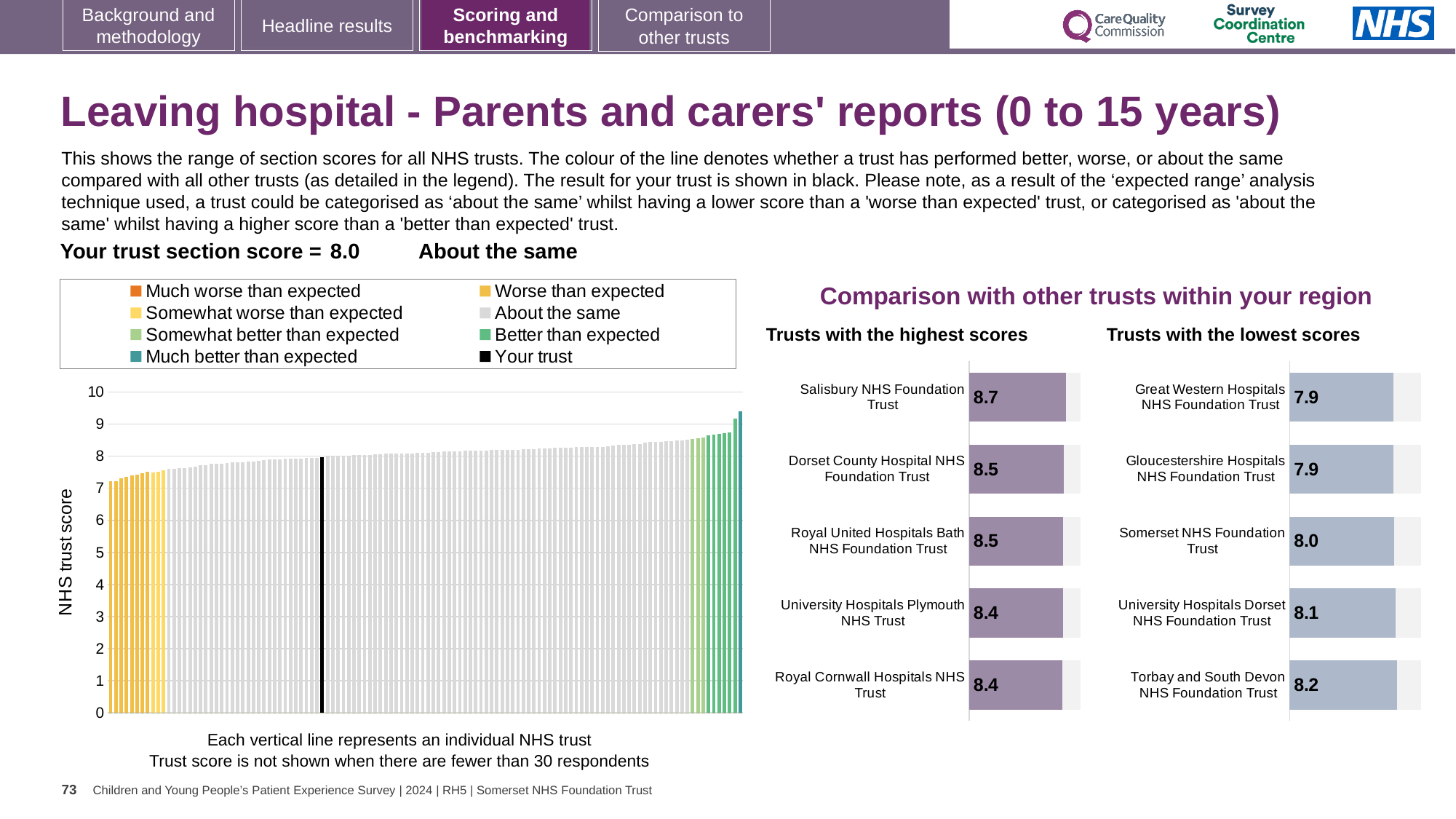
How many trusts are listed in the 'Trusts with the highest scores' chart? 5 In the 'Trusts with the lowest scores' chart, what is the score for Torbay and South Devon NHS Foundation Trust? 8.2 How many entries does the legend of the 'NHS trust score' chart on the left list? 8 In the 'Trusts with the highest scores' chart, what is the difference between the scores of Salisbury NHS Foundation Trust and Royal Cornwall Hospitals NHS Trust? 0.3 What kind of chart is the 'NHS trust score' chart on the left of the slide? Bar chart In the 'Trusts with the lowest scores' chart, which trust has the highest score shown? Torbay and South Devon NHS Foundation Trust In the 'Trusts with the highest scores' chart, what is the score for Salisbury NHS Foundation Trust? 8.7 In the 'Trusts with the highest scores' chart, which trust has the highest score? Salisbury NHS Foundation Trust In the 'Trusts with the highest scores' chart, what is the score for University Hospitals Plymouth NHS Trust? 8.4 In the 'Trusts with the lowest scores' chart, what is the score for Somerset NHS Foundation Trust? 8.0 In the 'Trusts with the lowest scores' chart, which has the larger score: Somerset NHS Foundation Trust or University Hospitals Dorset NHS Foundation Trust? University Hospitals Dorset NHS Foundation Trust In the 'Trusts with the lowest scores' chart, what is the difference between the scores of Torbay and South Devon NHS Foundation Trust and Great Western Hospitals NHS Foundation Trust? 0.3